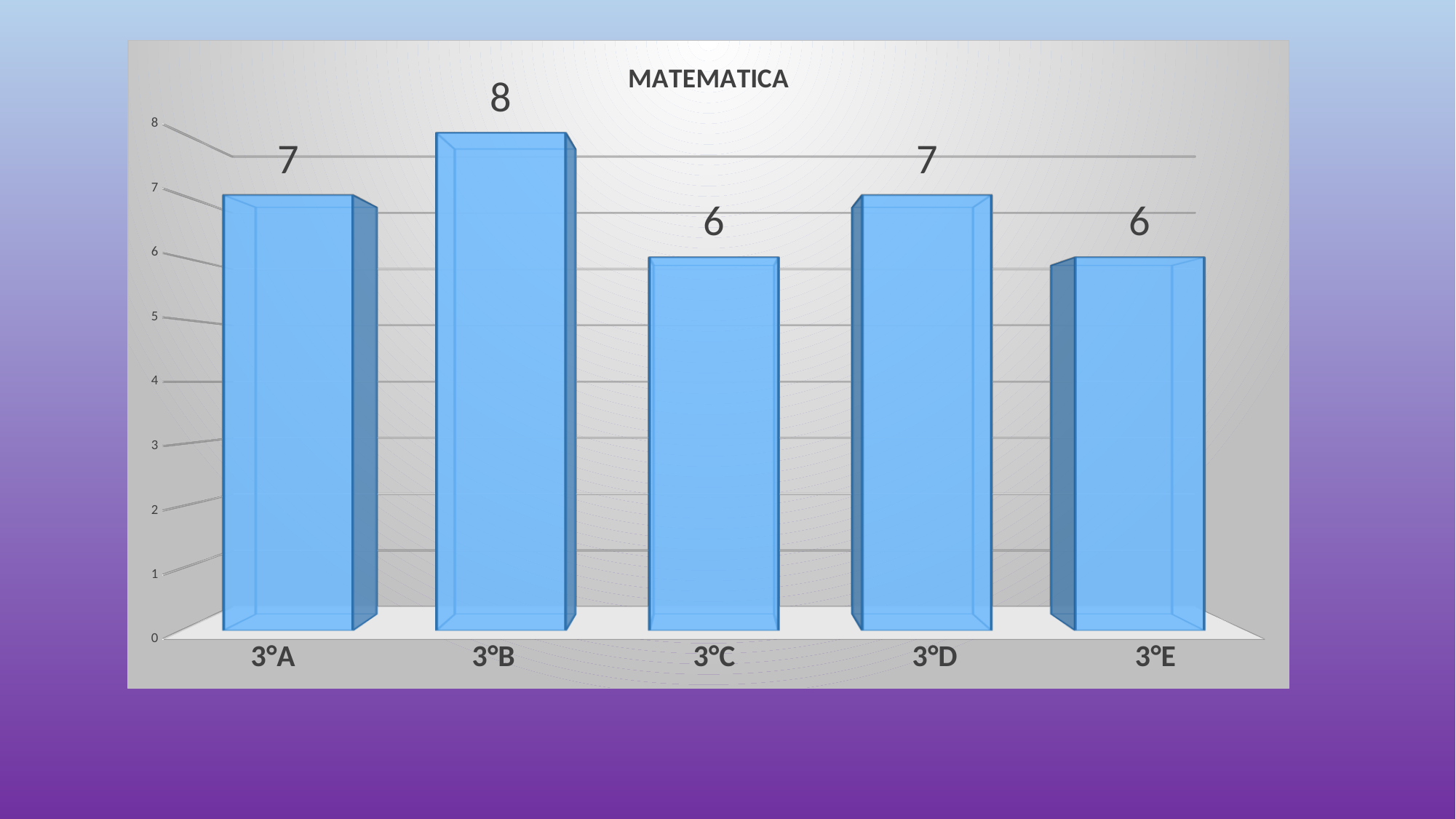
What kind of chart is shown? bar chart What is the difference between the values for 3°A and 3°E? 1 What is the value for 3°A? 7 What is the title of the chart? MATEMATICA Which is larger, the value for 3°D or the value for 3°E? 3°D What is the value for 3°C? 6 Is the value for 3°B greater or less than 5? greater Which category has the highest value? 3°B What is the difference between the values for 3°B and 3°C? 2 How many categories are shown on the x axis? 5 What is the value for 3°E? 6 What is the value for 3°B? 8